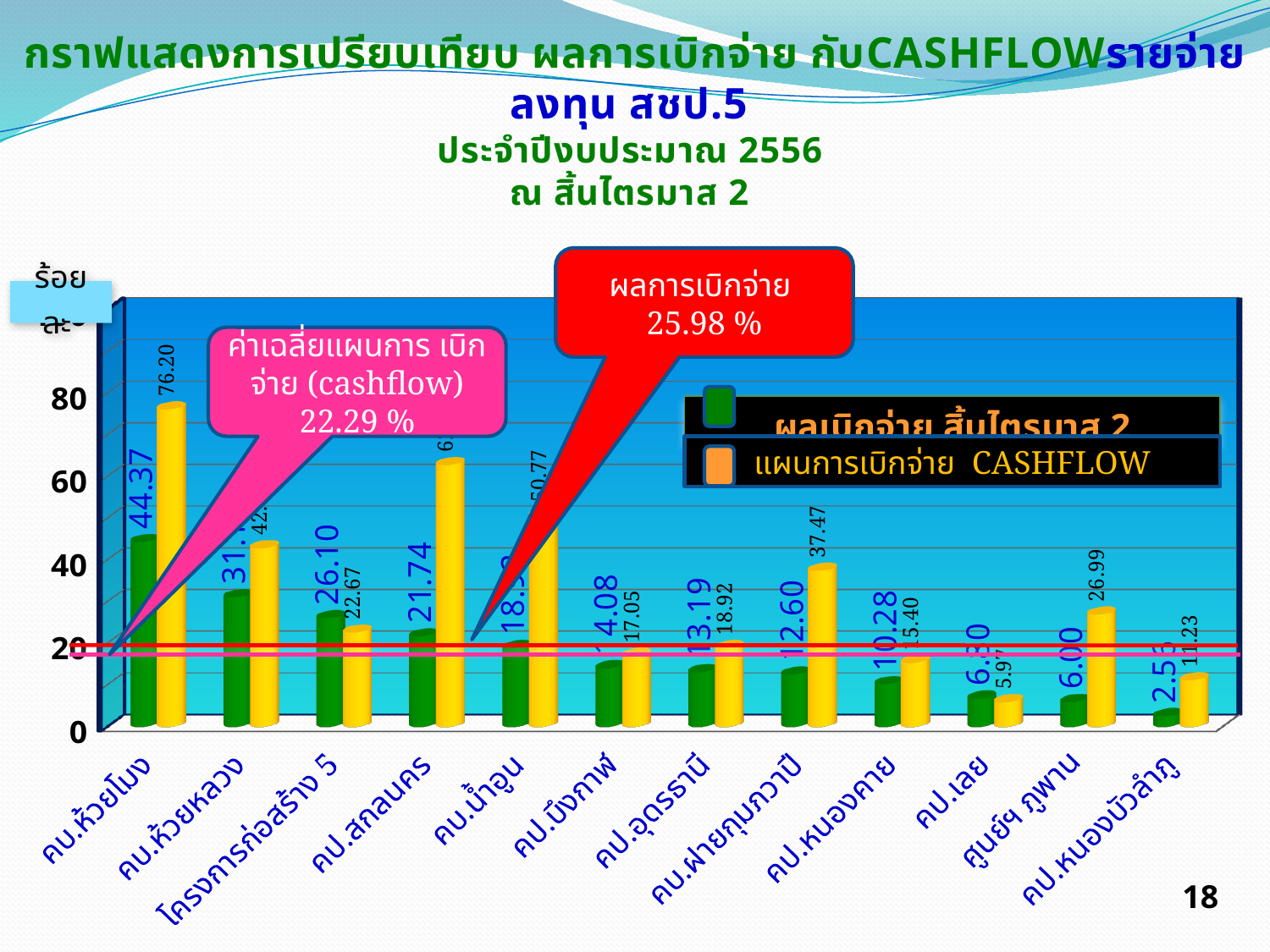
What is the แผนการเบิกจ่าย CASHFLOW value for คบ.ห้วยโมง? 76.20 How many series does the chart legend list? 2 What kind of chart is shown on the slide? bar chart Which category has the highest แผนการเบิกจ่าย CASHFLOW value? คบ.ห้วยโมง Which category has the lowest ผลเบิกจ่าย สิ้นไตรมาส 2 value? คป.หนองบัวลำภู For คป.เลย, which is larger: ผลเบิกจ่าย สิ้นไตรมาส 2 or แผนการเบิกจ่าย CASHFLOW? ผลเบิกจ่าย สิ้นไตรมาส 2 Is the แผนการเบิกจ่าย CASHFLOW value for คป.สกลนคร greater or less than 40? greater What is the difference between the แผนการเบิกจ่าย CASHFLOW and ผลเบิกจ่าย สิ้นไตรมาส 2 values for คบ.ฝายกุมภวาปี? 24.87 What is the ผลเบิกจ่าย สิ้นไตรมาส 2 value for โครงการก่อสร้าง 5? 26.10 What is the แผนการเบิกจ่าย CASHFLOW value for ศูนย์ฯ ภูพาน? 26.99 What is the ผลเบิกจ่าย สิ้นไตรมาส 2 value for คป.หนองคาย? 10.28 How many categories are shown on the x axis of the chart? 12